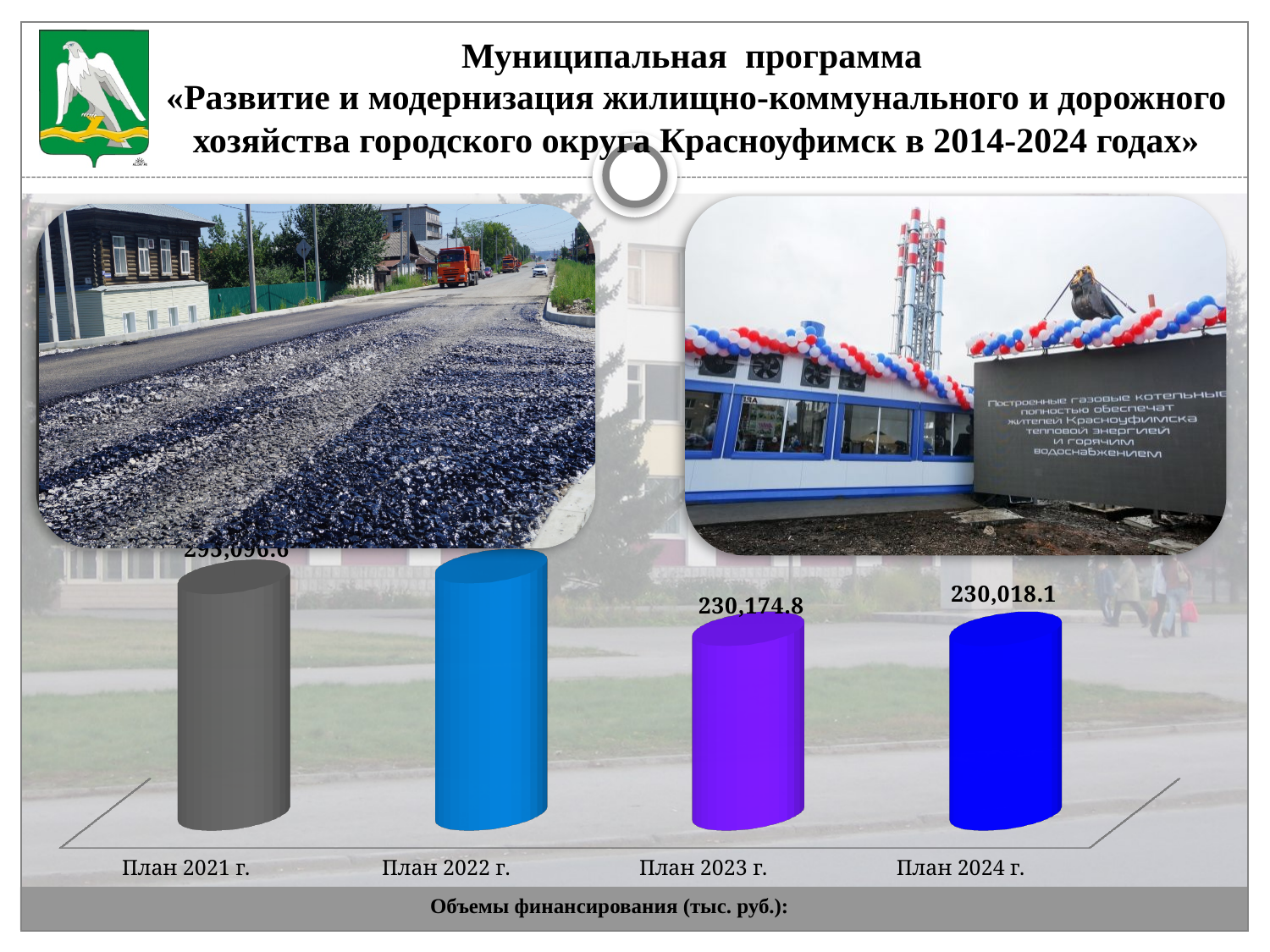
Which is larger, the value for План 2021 г. or План 2023 г.? План 2021 г. What colour is the bar for План 2023 г.? Purple Which is larger, the value for План 2022 г. or План 2024 г.? План 2022 г. Do the values generally rise or fall from План 2021 г. to План 2024 г.? Fall What is the title of the chart? Объемы финансирования (тыс. руб.): What is the value for План 2023 г.? 230,174.8 What is the value for План 2024 г.? 230,018.1 What kind of chart is shown on the slide? Bar chart How many categories are shown on the chart? 4 Which is larger, the value for План 2023 г. or План 2024 г.? План 2023 г. What is the difference between the values for План 2023 г. and План 2024 г.? 156.7